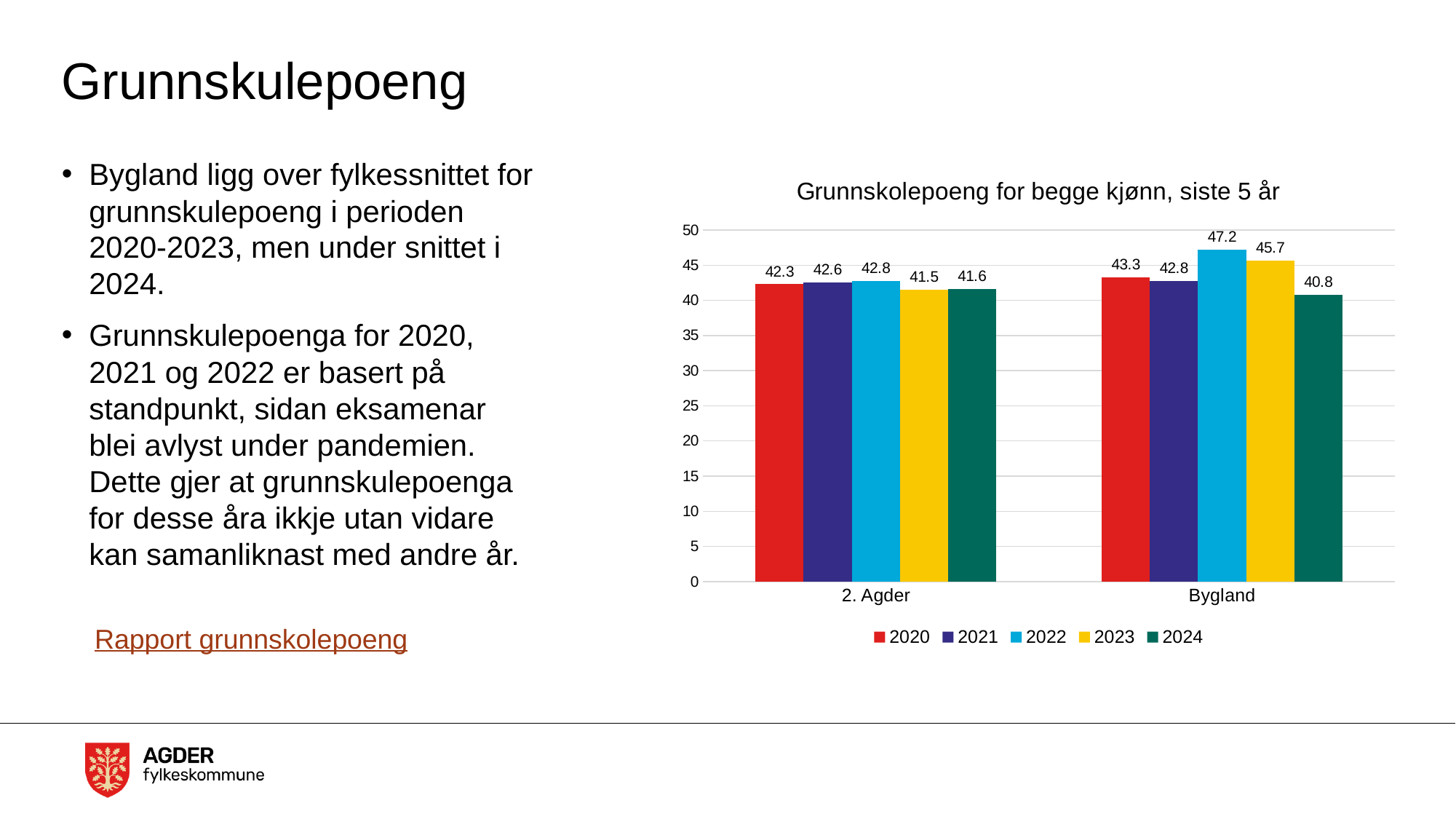
What is the value for Bygland in 2024? 40.8 What kind of chart is this? Bar chart What is the value for Bygland in 2022? 47.2 What is the title of the chart? Grunnskolepoeng for begge kjønn, siste 5 år How many series does the legend list? 5 Which year has the highest value for Bygland? 2022 Which year has the lowest value for 2. Agder? 2023 Which is larger in 2024, the value for 2. Agder or for Bygland? 2. Agder What is the value for 2. Agder in 2023? 41.5 What is the difference between the Bygland and 2. Agder values in 2022? 4.4 Which colour represents 2022 in the legend? Light blue How many categories are shown on the x axis? 2